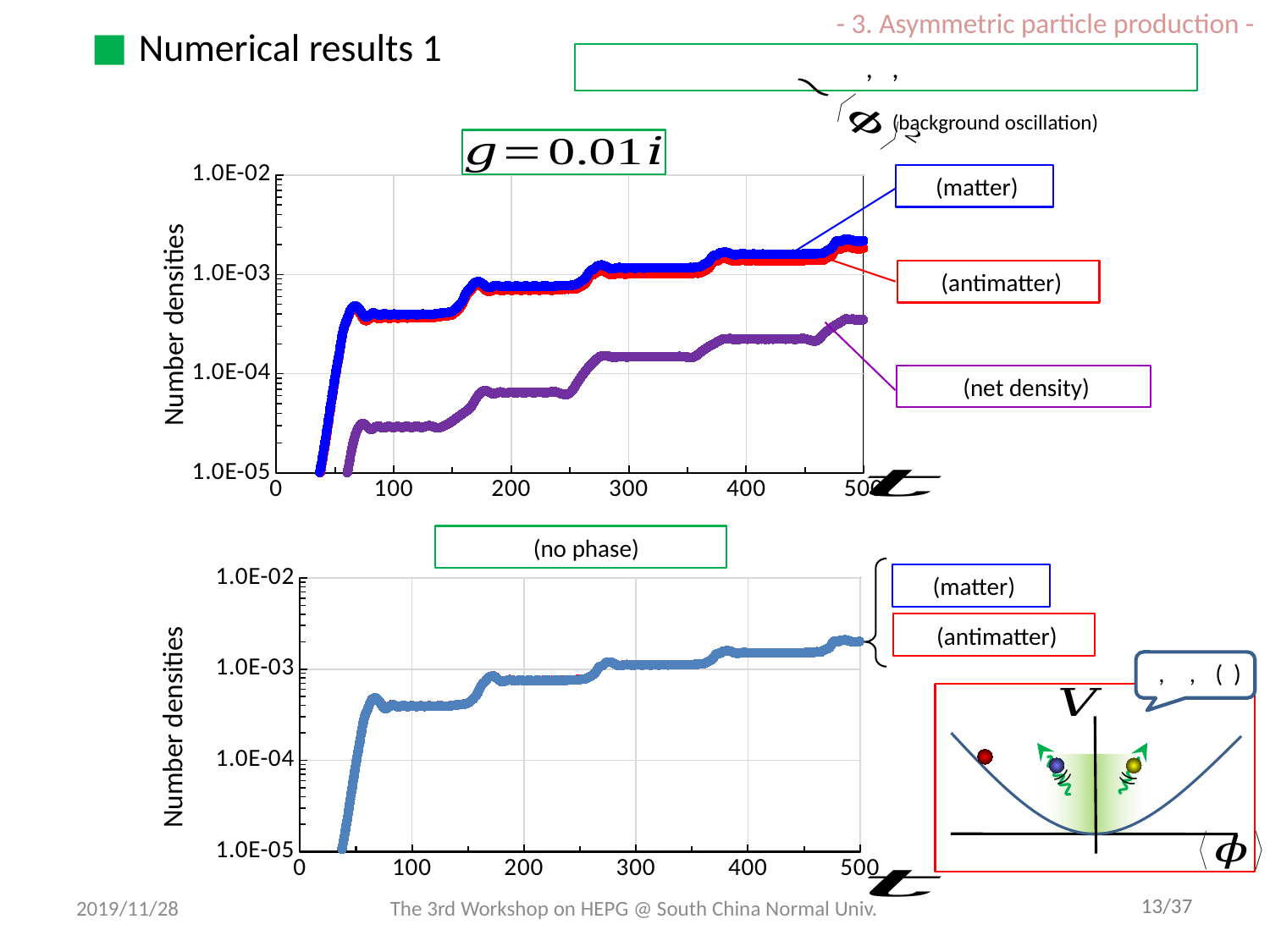
What is the y-axis label of the top chart? Number densities In the top chart (g = 0.01i), which series has the lowest values? net density In the top chart (g = 0.01i), is the matter density at t = 400 greater or less than 1.0E-03? greater In the top chart (g = 0.01i), how many series are labelled? 3 In the bottom chart (no phase), do the number densities rise or fall as t increases? rise In the bottom chart (no phase), is the number density at t = 100 greater or less than 1.0E-03? less In the top chart (g = 0.01i), is the net density at t = 100 greater or less than 1.0E-04? less In the bottom chart (no phase), how many series are labelled? 2 In the top chart (g = 0.01i), at t = 300, which is larger: the matter density or the net density? matter In the top chart (g = 0.01i), do the net density values rise or fall as t increases? rise Is the top chart (g = 0.01i) a bar chart or a line chart? line chart